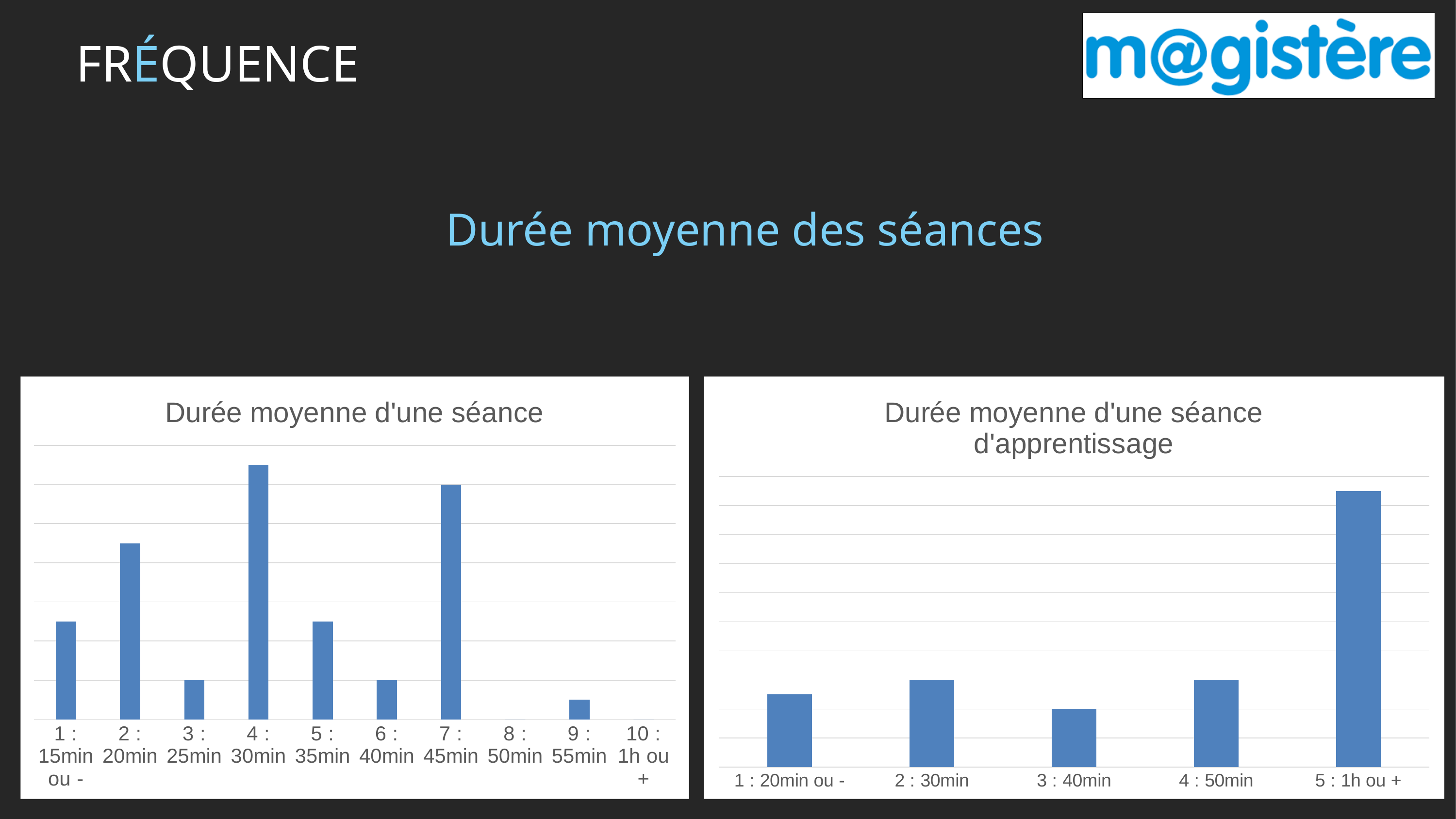
In the chart titled "Durée moyenne d'une séance" (left), which category has the tallest bar? 4 : 30min In the chart titled "Durée moyenne d'une séance d'apprentissage" (right), which category has the tallest bar? 5 : 1h ou + In the chart titled "Durée moyenne d'une séance d'apprentissage" (right), which bar is taller: "1 : 20min ou -" or "3 : 40min"? 1 : 20min ou - How many charts are shown on the slide? 2 What is the title of the right-hand chart on the slide? Durée moyenne d'une séance d'apprentissage In the chart titled "Durée moyenne d'une séance" (left), which bar is taller: "2 : 20min" or "5 : 35min"? 2 : 20min In the chart titled "Durée moyenne d'une séance" (left), which bar is taller: "4 : 30min" or "7 : 45min"? 4 : 30min In the chart titled "Durée moyenne d'une séance d'apprentissage" (right), how many categories are shown on the x axis? 5 In the chart titled "Durée moyenne d'une séance d'apprentissage" (right), which category has the shortest bar? 3 : 40min What kind of chart is the left chart, "Durée moyenne d'une séance"? bar chart In the chart titled "Durée moyenne d'une séance" (left), how many categories are shown on the x axis? 10